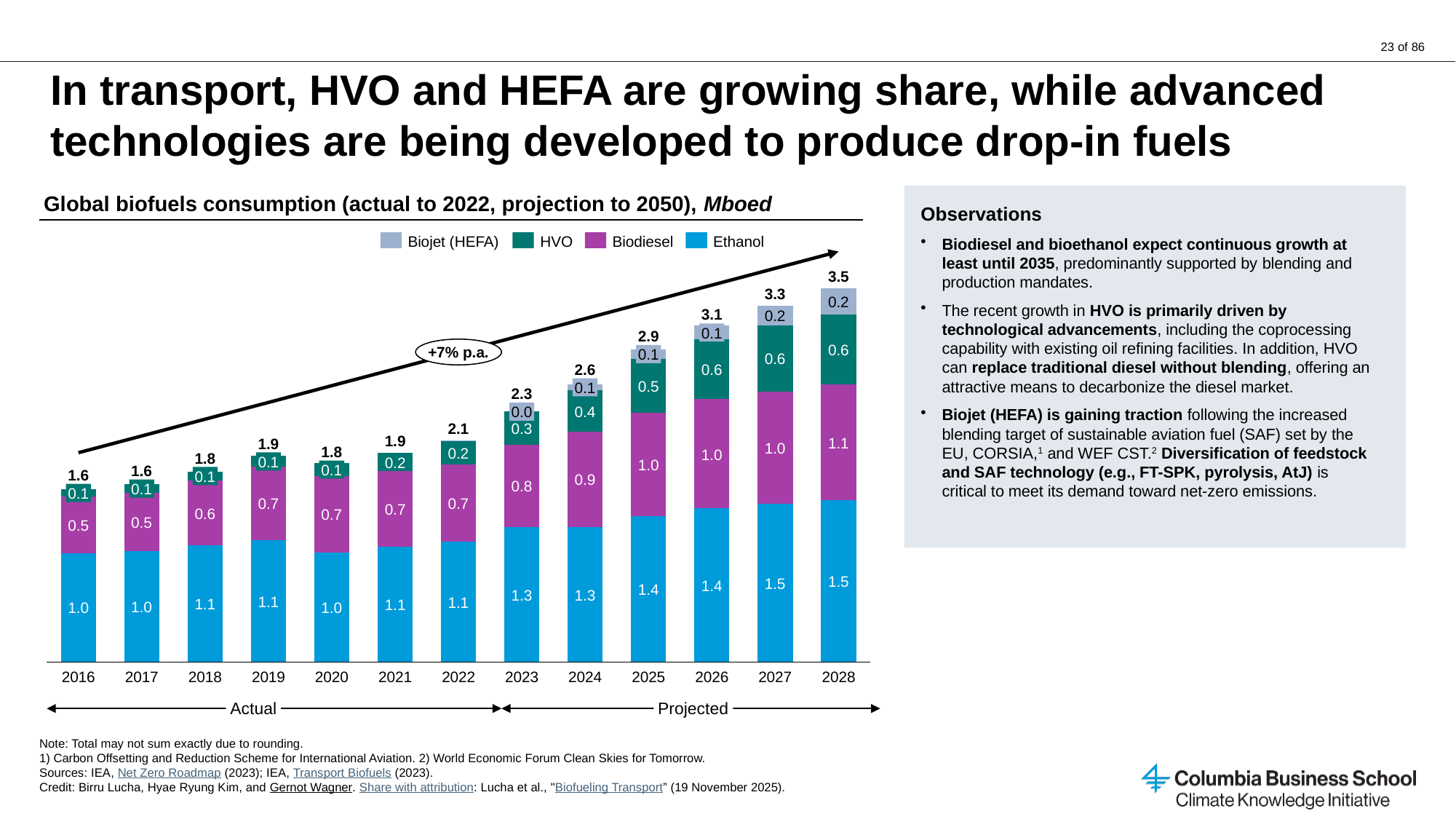
What annual growth rate is labelled on the arrow above the bars? +7% p.a. What is the Ethanol value for 2028? 1.5 What is the difference between the total for 2028 and the total for 2016? 1.9 What is the HVO value for 2026? 0.6 How many years are shown on the x axis? 13 What is the total biofuels consumption shown for 2025? 2.9 What is the Biodiesel value for 2022? 0.7 Which year has the highest total biofuels consumption? 2028 How many series does the legend list? 4 What is the Biojet (HEFA) value for 2027? 0.2 Which is larger, the Biodiesel value for 2028 or the HVO value for 2028? Biodiesel (1.1) What kind of chart is shown? Stacked bar chart